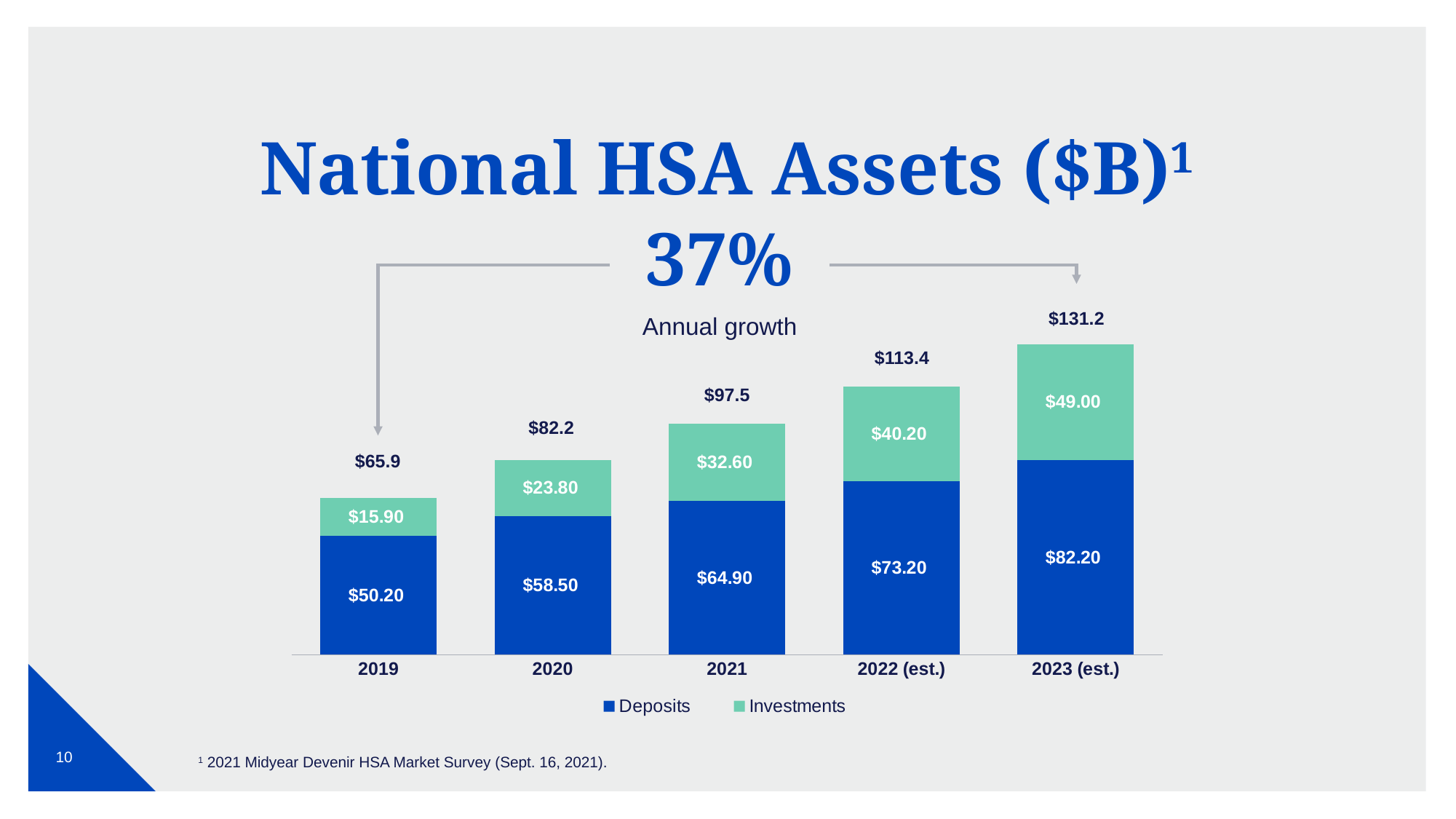
What kind of chart is shown on the slide? Stacked bar chart How many series does the legend list? 2 What is the Investments value for 2023 (est.)? $49.00 Which year has the lowest Investments value? 2019 What is the Deposits value for 2019? $50.20 How many years are shown on the x axis? 5 Which year has the highest total HSA assets? 2023 (est.) What is the total of the stacked bar for 2022 (est.)? $113.4 Which is larger, the Investments value for 2020 or the Investments value for 2021? 2021 What is the difference between the Deposits values for 2023 (est.) and 2022 (est.)? $9.00 What is the Investments value for 2021? $32.60 Do the total HSA assets rise or fall from 2019 to 2023 (est.)? Rise